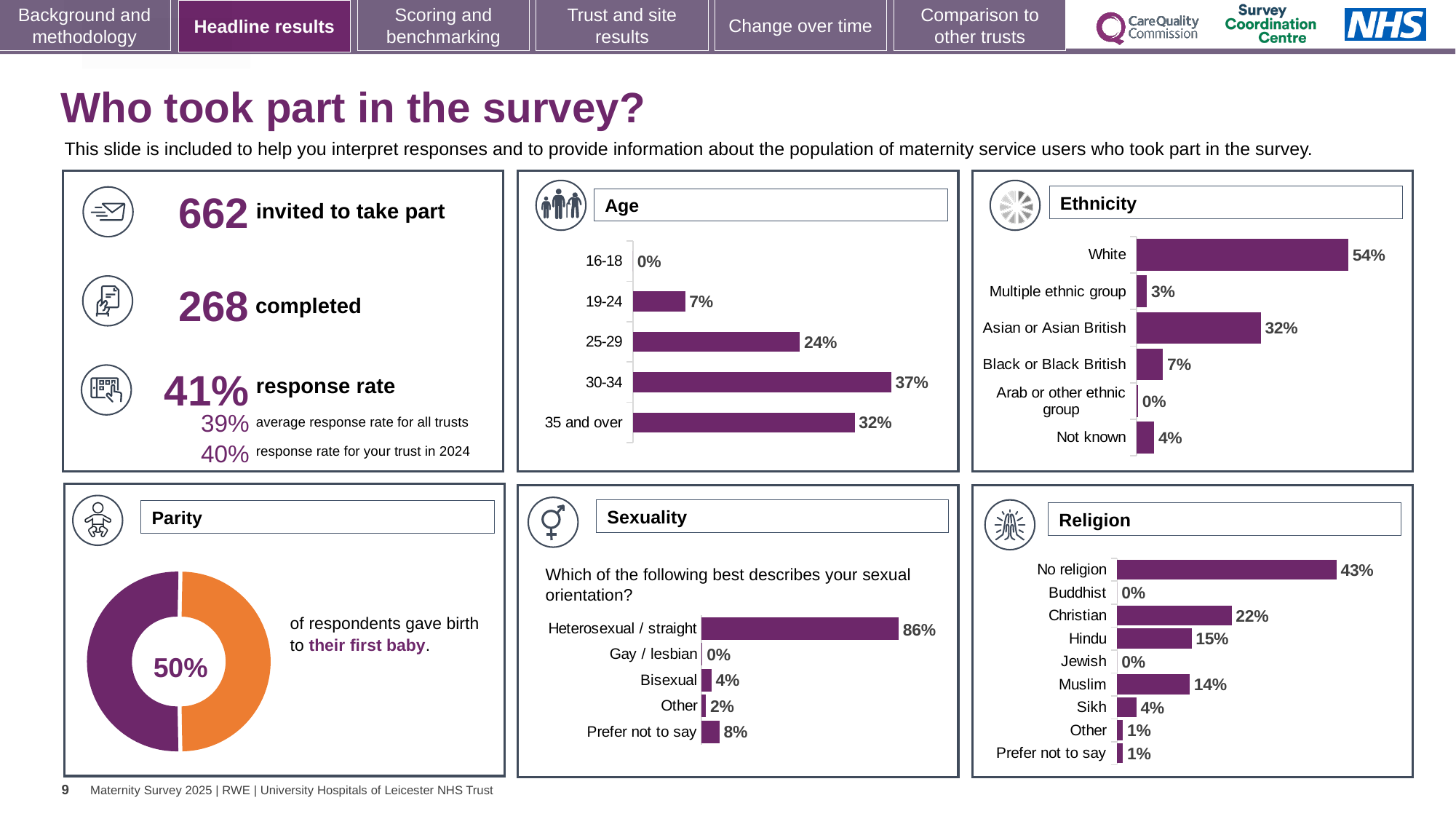
In the Ethnicity chart, what is the value for Asian or Asian British? 32% In the Age chart, which age group has the highest percentage? 30-34 In the Religion chart, which category has the highest value? No religion In the Religion chart, what is the value for Muslim? 14% In the Sexuality chart, how many categories are shown? 5 In the Ethnicity chart, how many categories are shown? 6 In the Ethnicity chart, what is the difference between White and Asian or Asian British? 22% In the Age chart, what percentage of respondents were aged 30-34? 37% What kind of chart is used in the Parity panel? Doughnut chart In the Religion chart, which is larger, Christian or Hindu? Christian In the Sexuality chart, what percentage of respondents answered Prefer not to say? 8% In the Parity chart, what share of respondents gave birth to their first baby? 50%